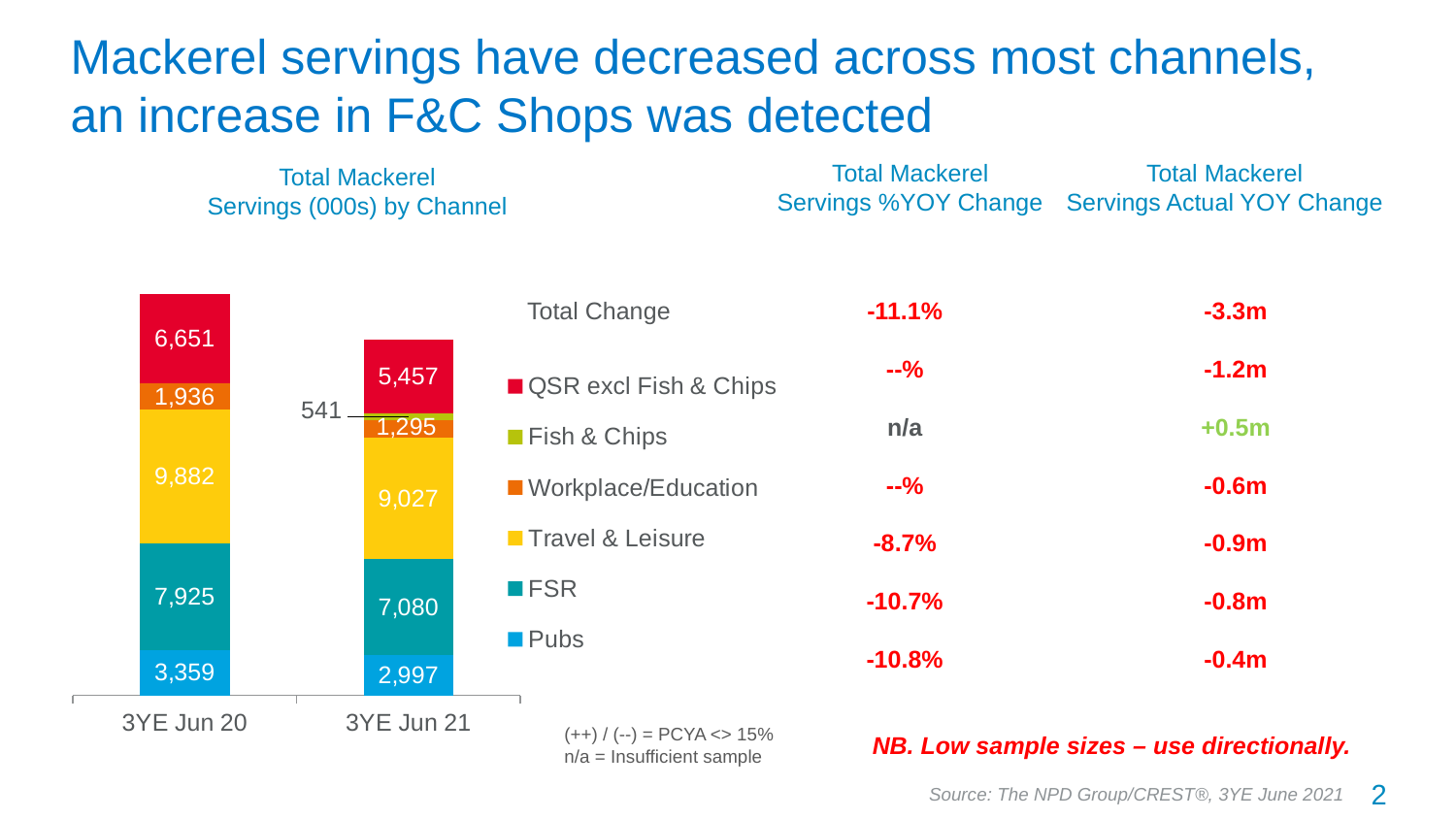
Which period has the larger value for QSR excl Fish & Chips, 3YE Jun 20 or 3YE Jun 21? 3YE Jun 20 What is the value for Fish & Chips in 3YE Jun 21? 541 What kind of chart is shown on the slide? Stacked bar chart What is the value for Pubs in 3YE Jun 21? 2,997 Which channel has the largest segment in the 3YE Jun 21 bar? Travel & Leisure How many series does the legend list? 6 What is the difference between the Workplace/Education values for 3YE Jun 20 and 3YE Jun 21? 641 Which channel has the smallest segment in the 3YE Jun 21 bar? Fish & Chips What is the total of the 3YE Jun 21 stacked bar? 26,397 What is the difference between the FSR values for 3YE Jun 20 and 3YE Jun 21? 845 What is the value for QSR excl Fish & Chips in 3YE Jun 20? 6,651 What is the value for Travel & Leisure in 3YE Jun 20? 9,882